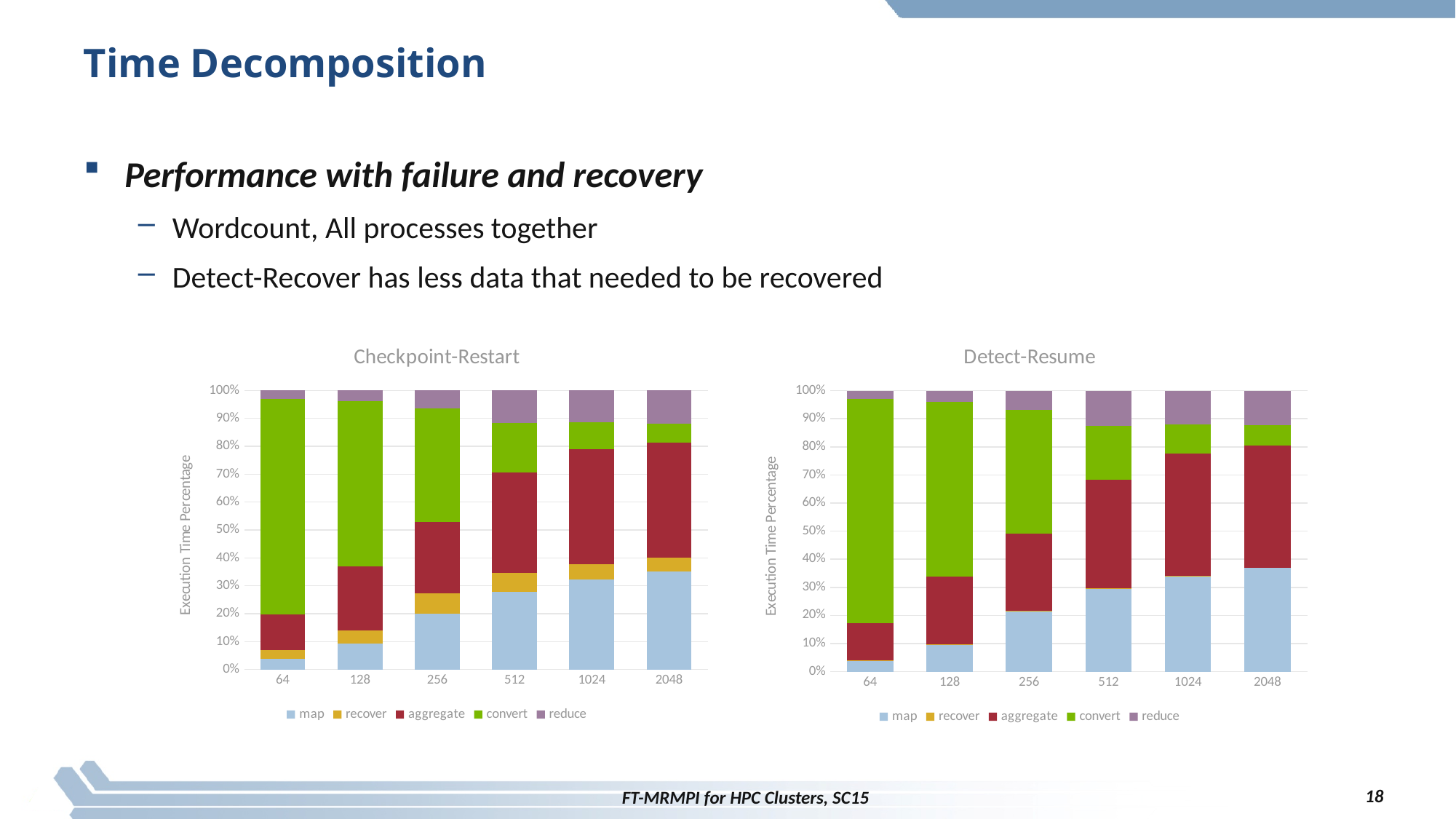
In the Detect-Resume chart, which process count has the largest map share? 2048 How many process-count categories are shown on the x axis of the Checkpoint-Restart chart? 6 In the Detect-Resume chart, which is larger: the convert share for 64 or the convert share for 2048? 64 In the Detect-Resume chart, is the map share for 1024 greater or less than 30%? greater How many series does the legend of the Detect-Resume chart list? 5 In the Detect-Resume chart, is the map share for 64 greater or less than 10%? less In the Checkpoint-Restart chart, does the map share rise or fall as the number of processes increases from 64 to 2048? rises In the Checkpoint-Restart chart, is the map share for 2048 greater or less than 30%? greater What type of chart is the Checkpoint-Restart chart? stacked bar chart Which series is shown in green in the Checkpoint-Restart chart's legend? convert What is the y-axis label of the Detect-Resume chart? Execution Time Percentage